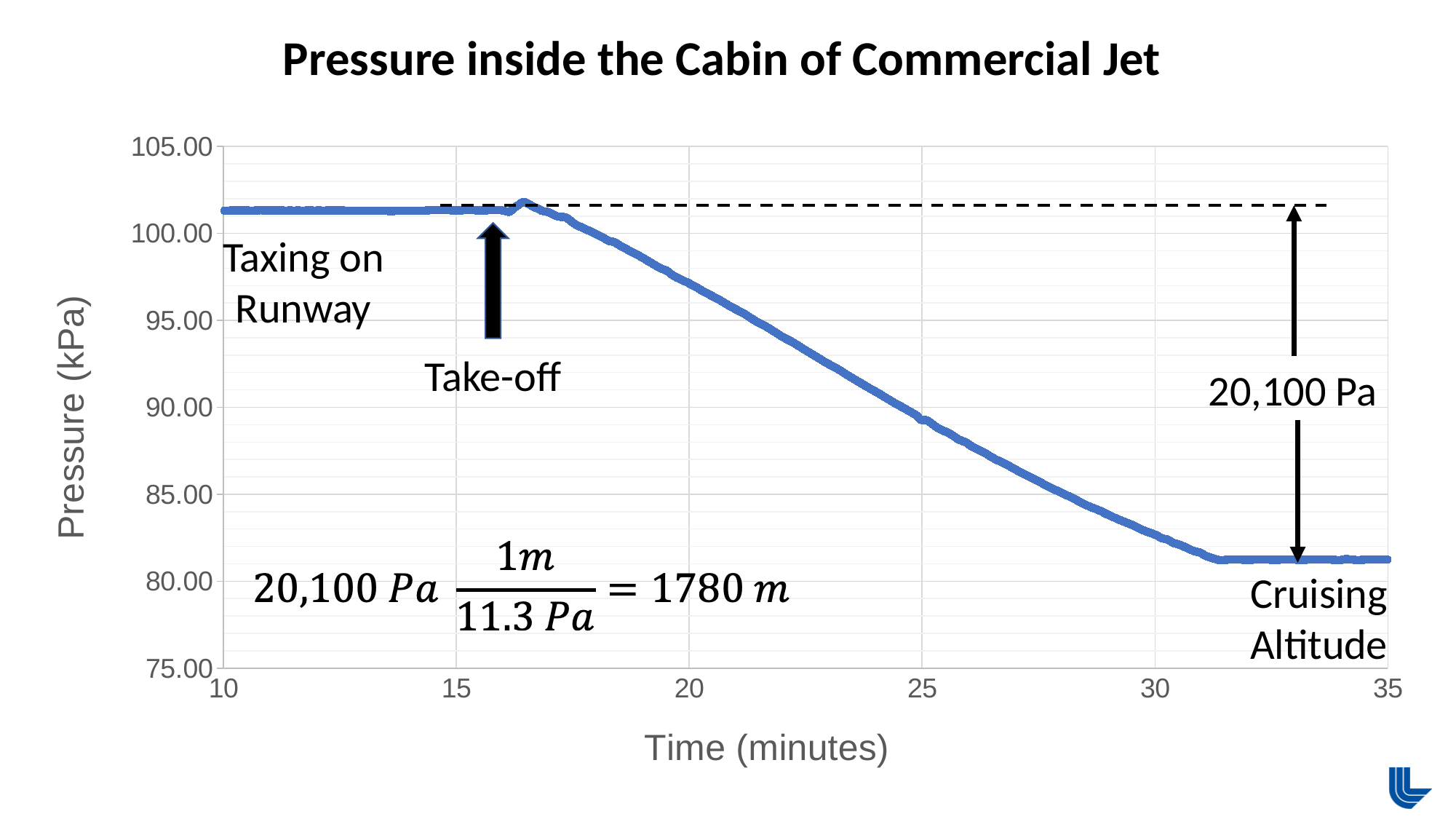
Is the pressure at 25 minutes greater or less than 90.00 kPa? less What altitude does the calculation on the slide give for the pressure drop? 1780 m Which is larger, the pressure at 15 minutes or the pressure at 30 minutes? 15 minutes What is the label of the y axis? Pressure (kPa) Is the pressure at 35 minutes greater or less than 85.00 kPa? less Is the pressure at 20 minutes greater or less than 95.00 kPa? greater According to the annotation, what is the pressure difference between taxiing and cruising altitude? 20,100 Pa What kind of chart is shown on the slide? line chart Does the cabin pressure rise or fall along the x axis after take-off? fall What is the title of the chart? Pressure inside the Cabin of Commercial Jet